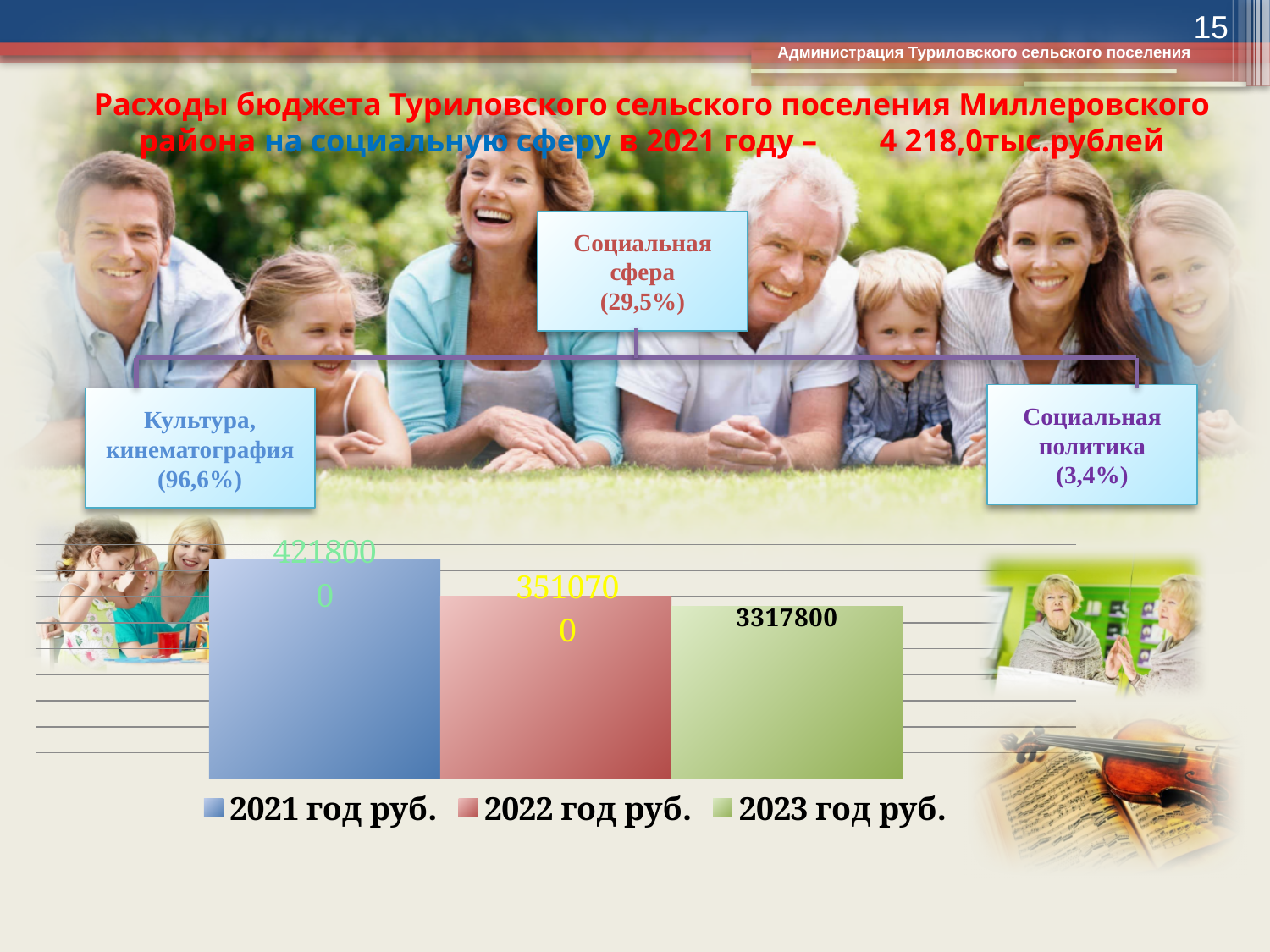
Which year has the highest value in the bar chart? 2021 год руб. What colour is the bar for 2022 год руб.? red What is the value for 2022 год руб. in the bar chart? 3510700 What kind of chart is shown on the slide? bar chart Do the values rise or fall from 2021 to 2023? fall What is the difference between the 2022 год руб. and 2023 год руб. values? 192900 What is the value for 2023 год руб. in the bar chart? 3317800 Which year has the lowest value in the bar chart? 2023 год руб. What is the difference between the 2021 год руб. and 2022 год руб. values? 707300 What is the value for 2021 год руб. in the bar chart? 4218000 How many series does the legend list? 3 Which is larger, the value for 2022 год руб. or 2023 год руб.? 2022 год руб.